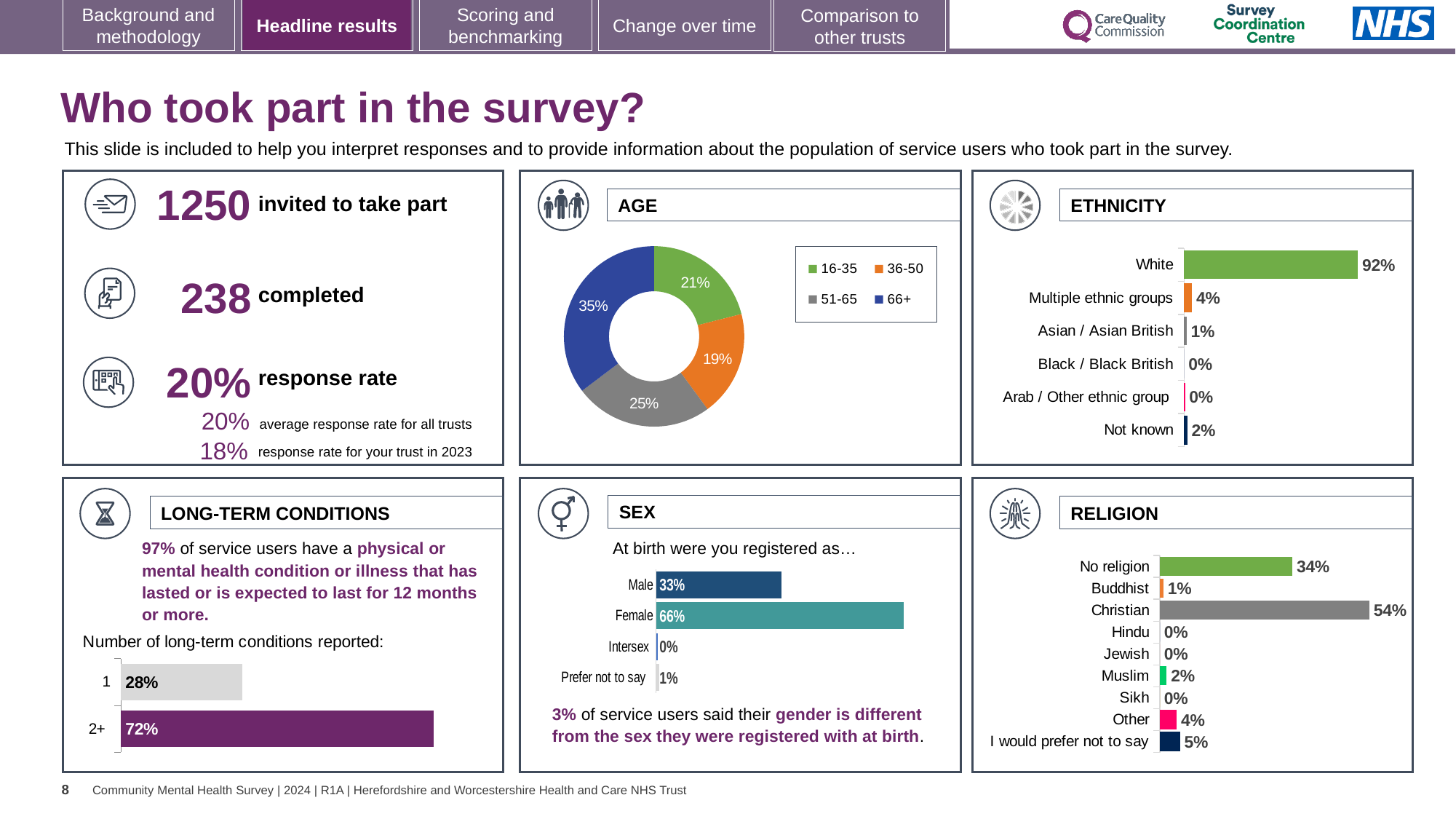
In the SEX chart, what is the value for Female? 66% In the SEX chart, which is larger, Male or Female? Female In the AGE chart, what percentage of respondents were aged 66+? 35% What kind of chart is the AGE chart? Donut (pie) chart How many age groups does the legend of the AGE chart list? 4 In the RELIGION chart, what is the value for Christian? 54% In the ETHNICITY chart, what is the value for Multiple ethnic groups? 4% In the AGE chart, which age group has the smallest share? 36-50 In the ETHNICITY chart, which category has the highest value? White In the LONG-TERM CONDITIONS chart, what percentage reported 2+ conditions? 72% How many categories are shown in the ETHNICITY chart? 6 In the ETHNICITY chart, what is the difference between White and Not known? 90%